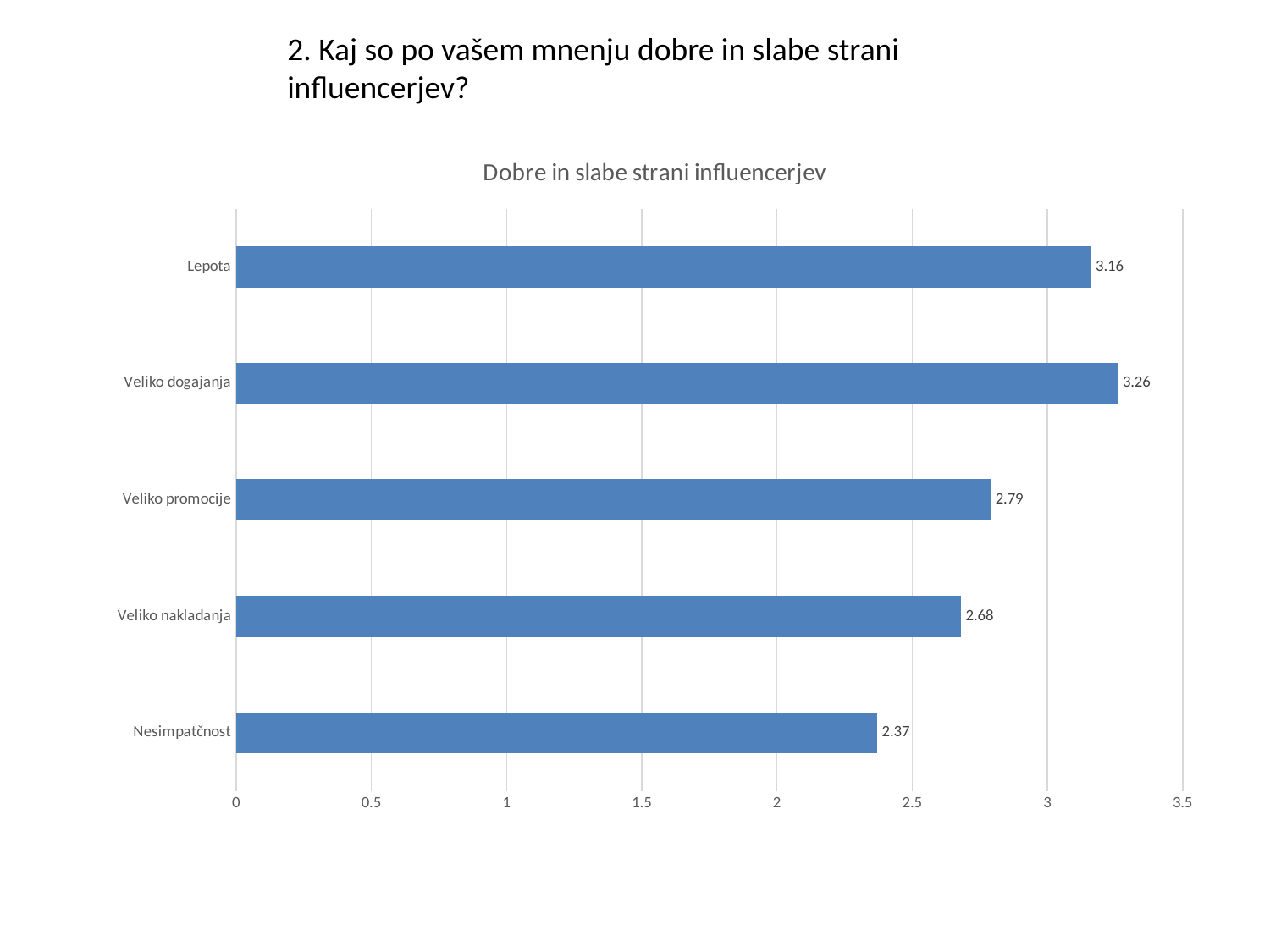
What is the value for Nesimpatčnost? 2.37 What is the difference between the values for Veliko promocije and Veliko nakladanja? 0.11 What is the difference between the values for Veliko dogajanja and Lepota? 0.1 What is the value for Veliko promocije? 2.79 Which category has the lowest value? Nesimpatčnost How many categories are shown in the chart? 5 What is the value for Veliko dogajanja? 3.26 Which category has the highest value? Veliko dogajanja Which is larger, the value for Veliko nakladanja or the value for Nesimpatčnost? Veliko nakladanja Is the value for Veliko nakladanja greater or less than 2.5? greater What is the value for Lepota? 3.16 What type of chart is shown on the slide? Bar chart